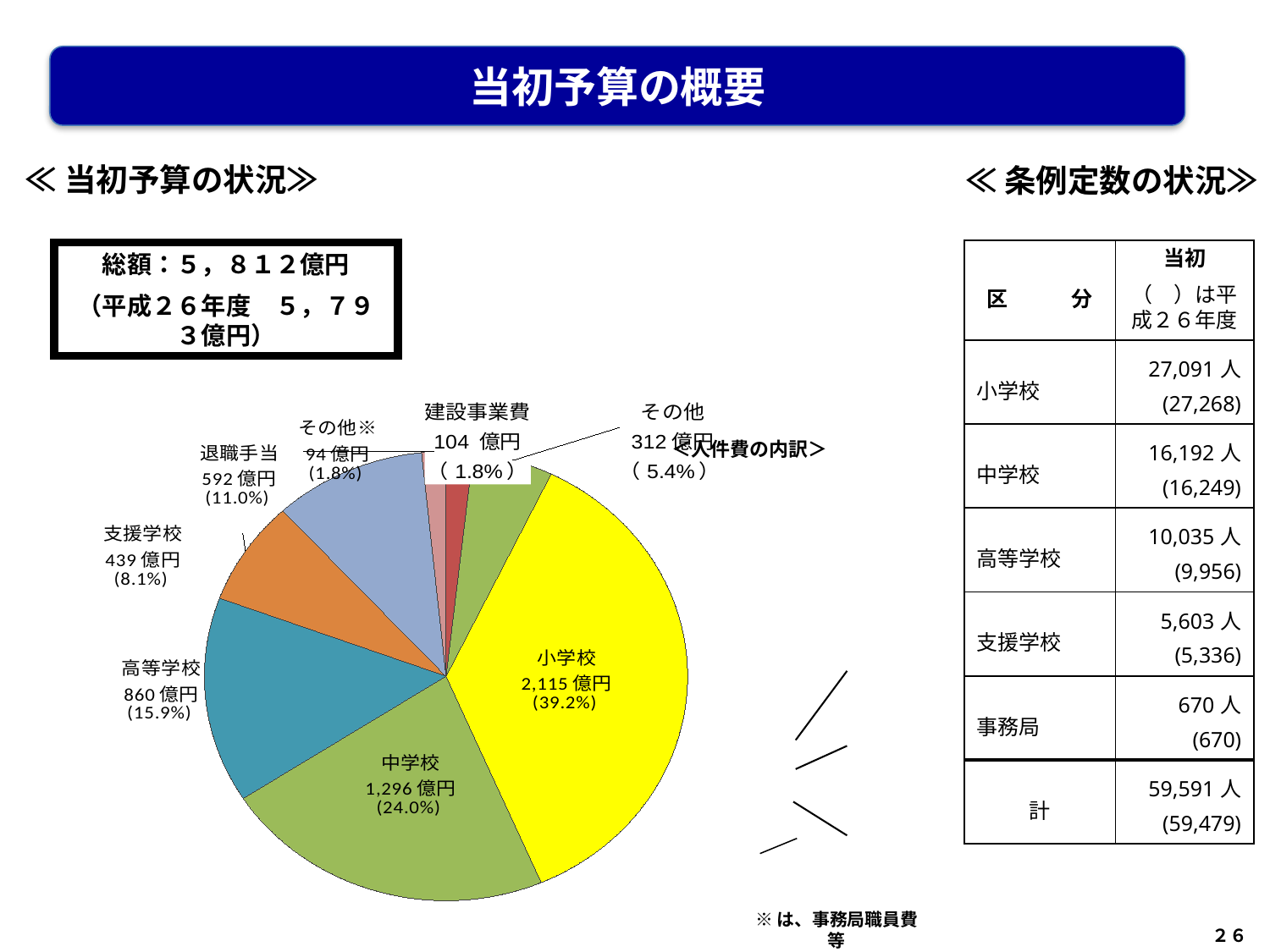
How many slices does the pie chart have? 8 What share of the pie does 小学校 represent? 39.2% What is the difference between the values for 小学校 and 中学校 in the pie chart? 819 億円 What share of the pie does 支援学校 represent? 8.1% Which category has the largest slice in the pie chart? 小学校 Which is larger in the pie chart, 高等学校 or 退職手当? 高等学校 What is the value for 建設事業費 in the pie chart? 104 億円 What is the value for 退職手当 in the pie chart? 592 億円 What is the value for 小学校 in the pie chart? 2,115 億円 What is the value for 中学校 in the pie chart? 1,296 億円 What kind of chart is shown on the slide? pie chart What is the value for 高等学校 in the pie chart? 860 億円